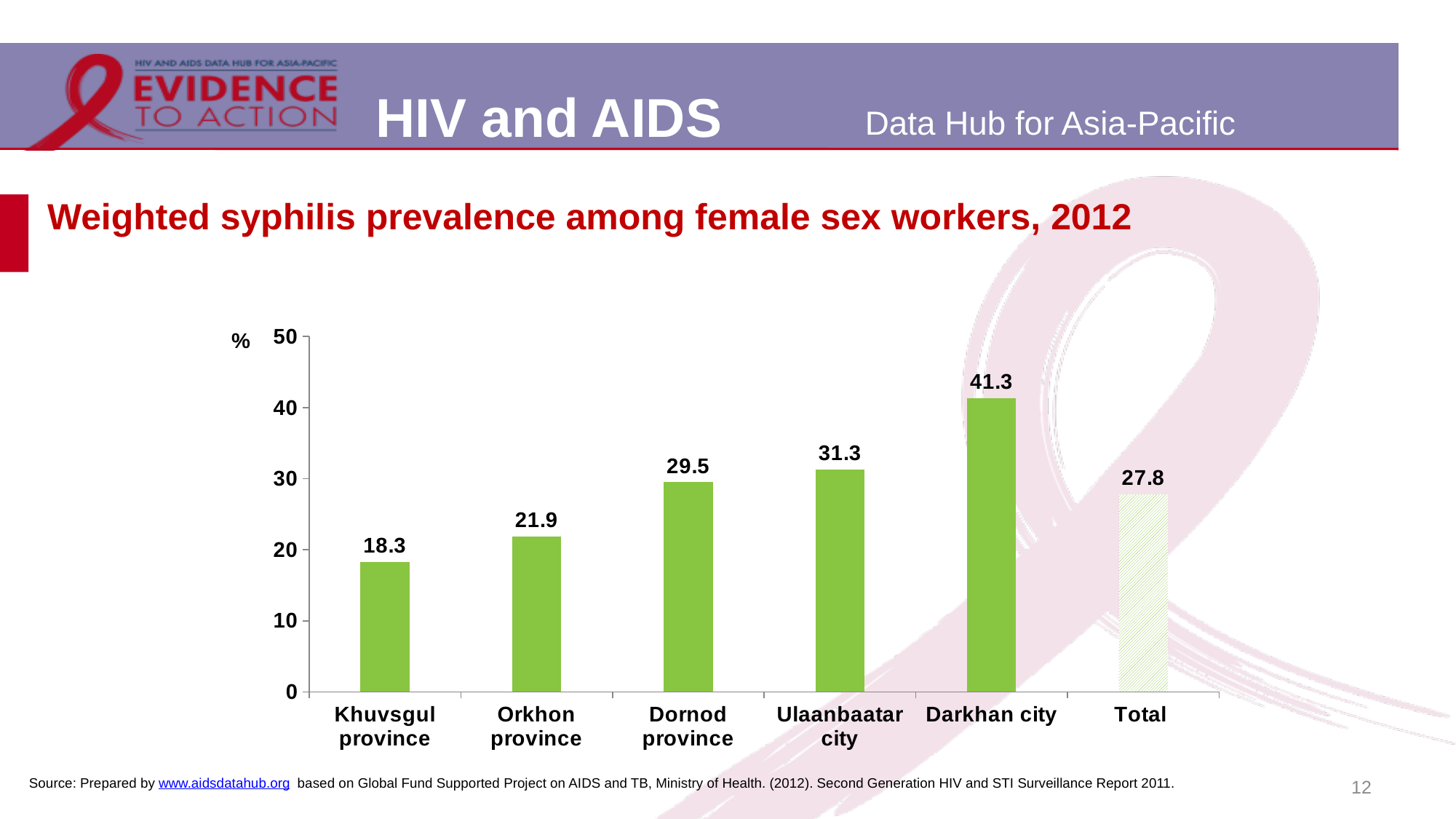
What is the difference between the values for Dornod province and Orkhon province? 7.6 What is the value shown for the Total bar? 27.8 What kind of chart is shown on the slide? Bar chart Which is larger, the value for Ulaanbaatar city or the value for Dornod province? Ulaanbaatar city Is the value for Orkhon province greater or less than 30? less How many bars are shown in the chart? 6 What is the weighted syphilis prevalence among female sex workers in Khuvsgul province? 18.3 What unit is shown on the y axis of the chart? % What is the difference between the values for Darkhan city and Ulaanbaatar city? 10 What is the weighted syphilis prevalence among female sex workers in Darkhan city? 41.3 Which location has the lowest weighted syphilis prevalence? Khuvsgul province Which location has the highest weighted syphilis prevalence? Darkhan city